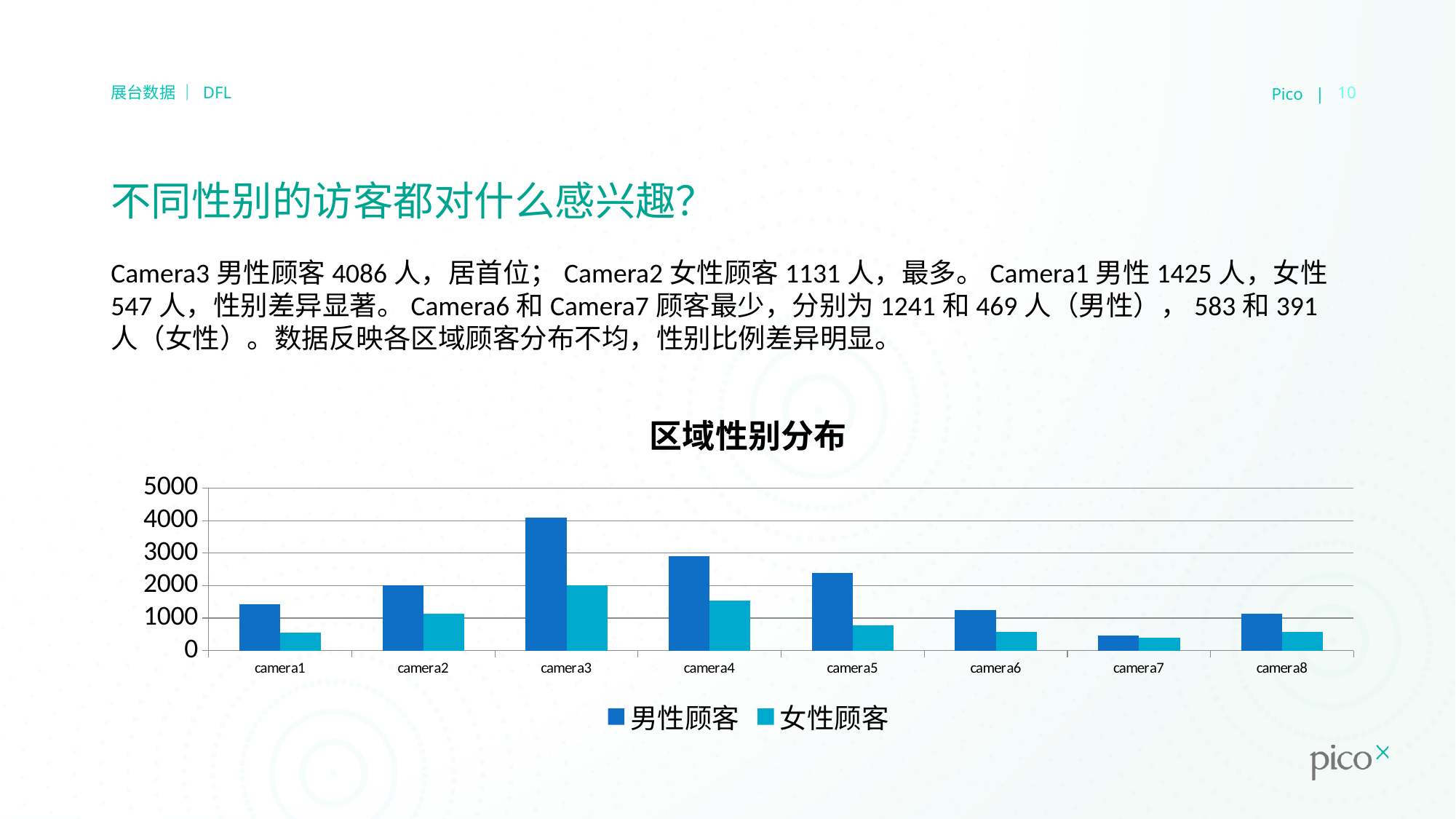
What kind of chart is shown on the slide? bar chart What is the title of the chart? 区域性别分布 How many 男性顾客 does camera3 have? 4086 What is the difference between 男性顾客 and 女性顾客 for camera1? 878 Which camera has the lowest value for 男性顾客? camera7 Which camera has the highest value for 男性顾客? camera3 How many series does the chart legend list? 2 Which camera has the highest value for 女性顾客? camera3 How many cameras (categories) are shown on the x axis of the chart? 8 Is the value for 男性顾客 at camera4 greater or less than 2000? greater Which is larger, 男性顾客 at camera4 or 男性顾客 at camera5? camera4 How many 女性顾客 does camera2 have? 1131